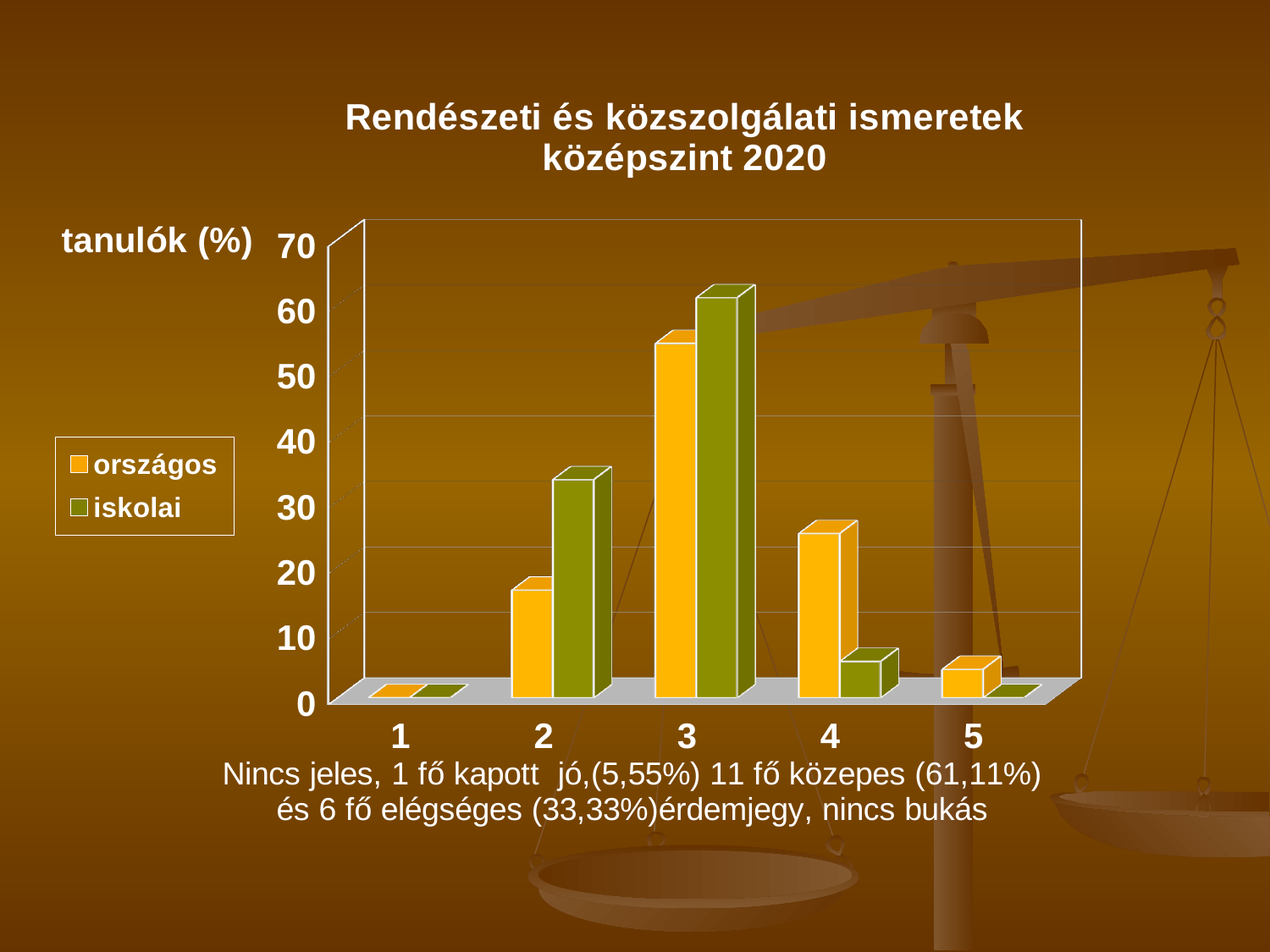
How many categories are shown on the x axis? 5 Is the value for iskolai in category 2 greater or less than 30? greater Is the value for országos in category 3 greater or less than 50? greater Is the value for országos in category 2 greater or less than 20? less Which category has the highest value for the országos series? 3 How many series does the legend list? 2 For category 2, which series has the larger value, országos or iskolai? iskolai What kind of chart is shown on the slide? bar chart Which category has the highest value for the iskolai series? 3 What is the value for iskolai in category 5? 0 For category 4, which series has the larger value, országos or iskolai? országos What label is shown on the vertical axis of the chart? tanulók (%)